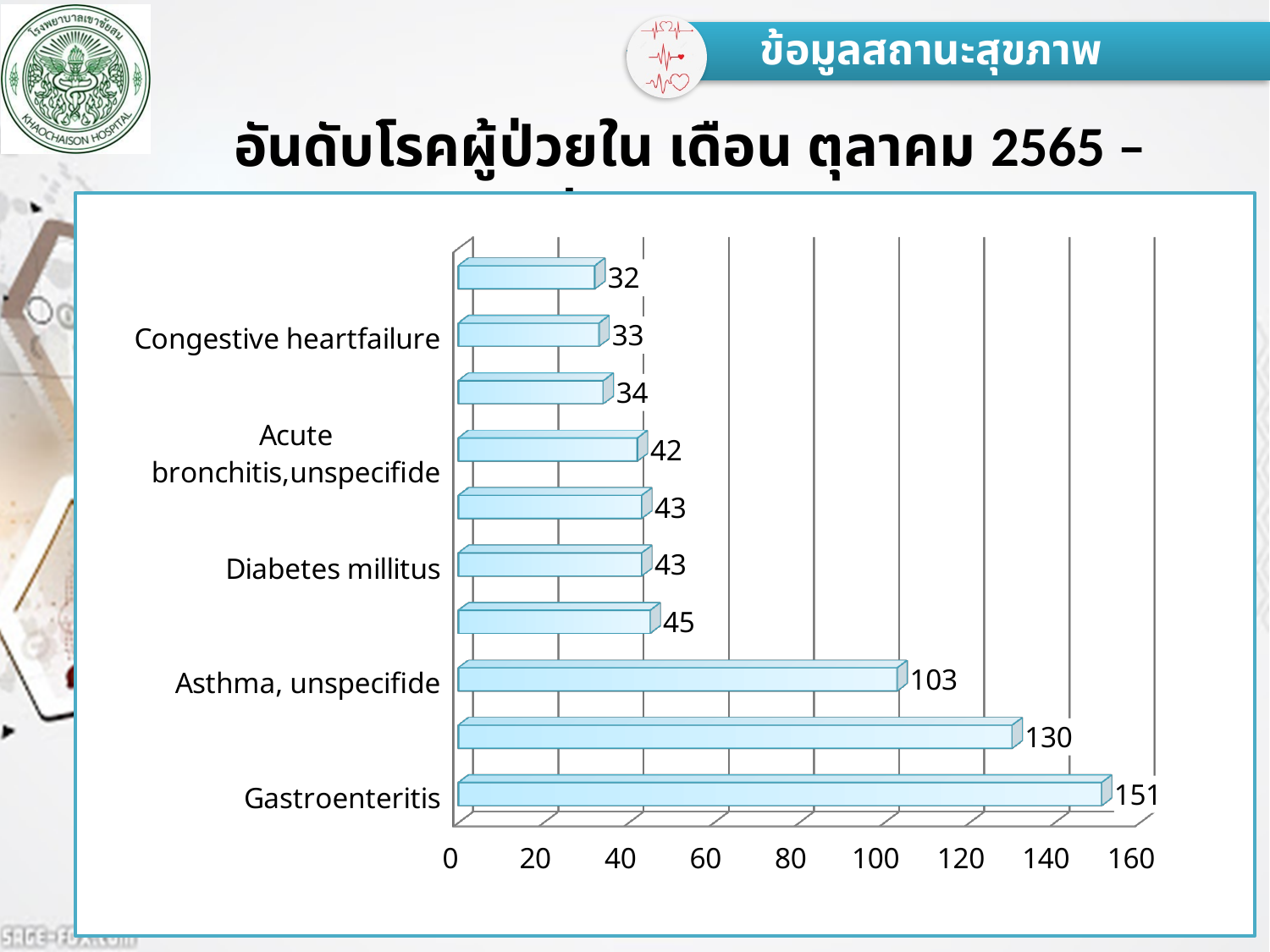
What is the value for Acute bronchitis,unspecifide? 42 What kind of chart is shown on the slide? bar chart What is the value for Gastroenteritis? 151 Which is larger, the value for Asthma, unspecifide or the value for Diabetes millitus? Asthma, unspecifide What is the value for Congestive heartfailure? 33 What is the value for Diabetes millitus? 43 What is the difference between the values for Gastroenteritis and Asthma, unspecifide? 48 What is the value for Asthma, unspecifide? 103 How many bars are plotted in the chart? 10 Is the value for Asthma, unspecifide greater or less than 100? greater Which labelled category has the highest value? Gastroenteritis What is the highest tick value shown on the horizontal axis? 160